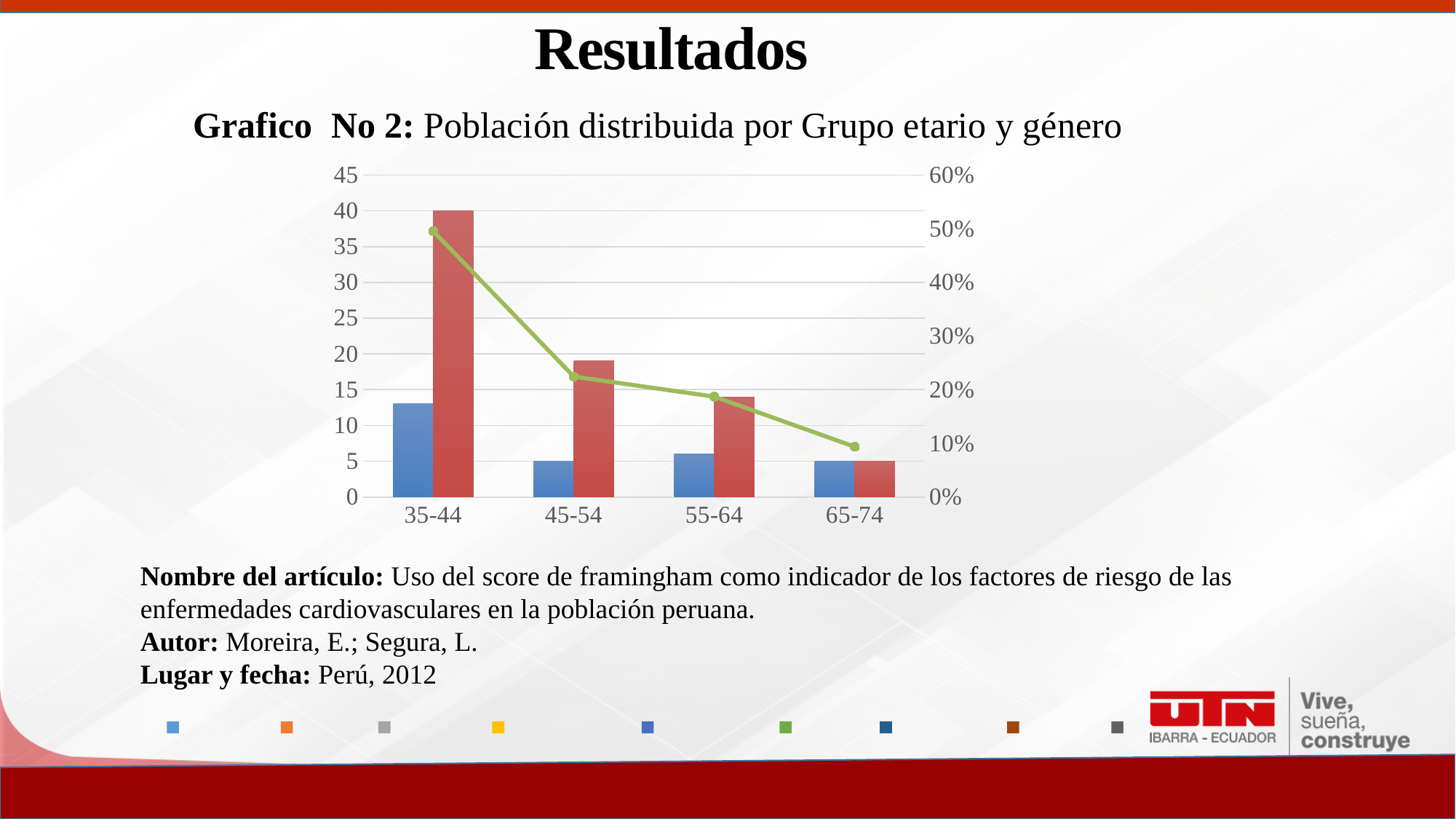
What is the value of the red bar for the 35-44 age group? 40 Does the green line rise or fall from the 35-44 group to the 65-74 group? fall Is the green line value for the 65-74 age group greater or less than 20%? less What kind of chart is shown on the slide? combination bar and line chart Is the value of the red bar for the 45-54 age group greater or less than 15? greater Which age group has the tallest red bar? 35-44 What is the difference between the red bar for 35-44 and the red bar for 65-74? 35 What is the value of the blue bar for the 45-54 age group? 5 Is the value of the blue bar for the 35-44 age group greater or less than 10? greater For the 55-64 age group, which bar is taller, the blue bar or the red bar? red bar Which age group has the shortest red bar? 65-74 How many age groups are shown on the x axis of the chart? 4